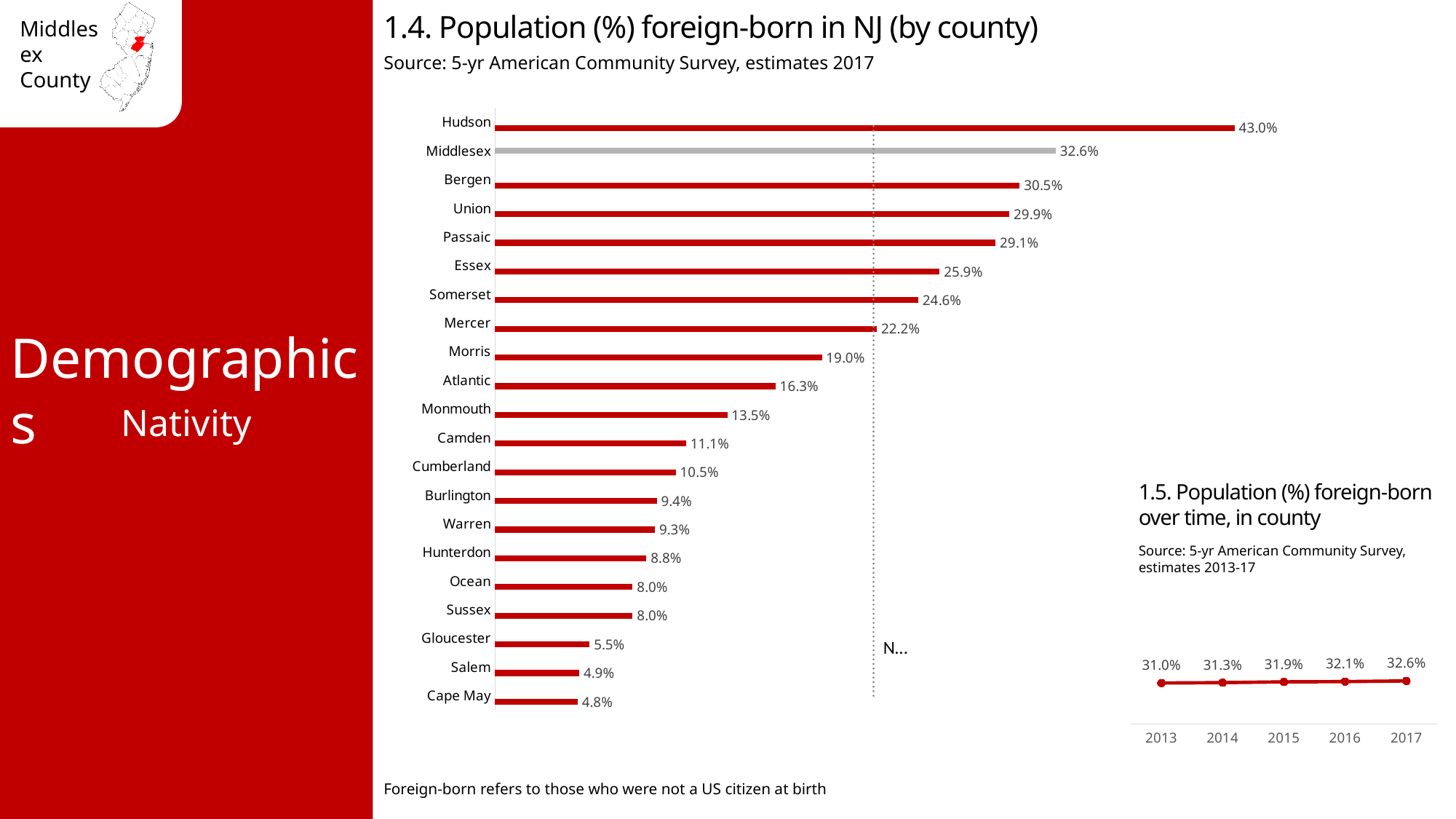
In the chart '1.5. Population (%) foreign-born over time, in county', do the values rise or fall from 2013 to 2017? Rise In the chart '1.5. Population (%) foreign-born over time, in county', what is the value for 2013? 31.0% What kind of chart is '1.4. Population (%) foreign-born in NJ (by county)'? Bar chart In the chart '1.4. Population (%) foreign-born in NJ (by county)', what is the value for Middlesex? 32.6% In the chart '1.4. Population (%) foreign-born in NJ (by county)', which bar is coloured grey instead of red? Middlesex In the chart '1.4. Population (%) foreign-born in NJ (by county)', what is the value for Mercer? 22.2% In the chart '1.4. Population (%) foreign-born in NJ (by county)', which is larger, Bergen or Union? Bergen In the chart '1.4. Population (%) foreign-born in NJ (by county)', how many counties are shown? 21 In the chart '1.4. Population (%) foreign-born in NJ (by county)', which county has the highest value? Hudson In the chart '1.4. Population (%) foreign-born in NJ (by county)', what is the difference between Hudson and Middlesex? 10.4% In the chart '1.5. Population (%) foreign-born over time, in county', how many years are plotted? 5 In the chart '1.4. Population (%) foreign-born in NJ (by county)', which county has the lowest value? Cape May